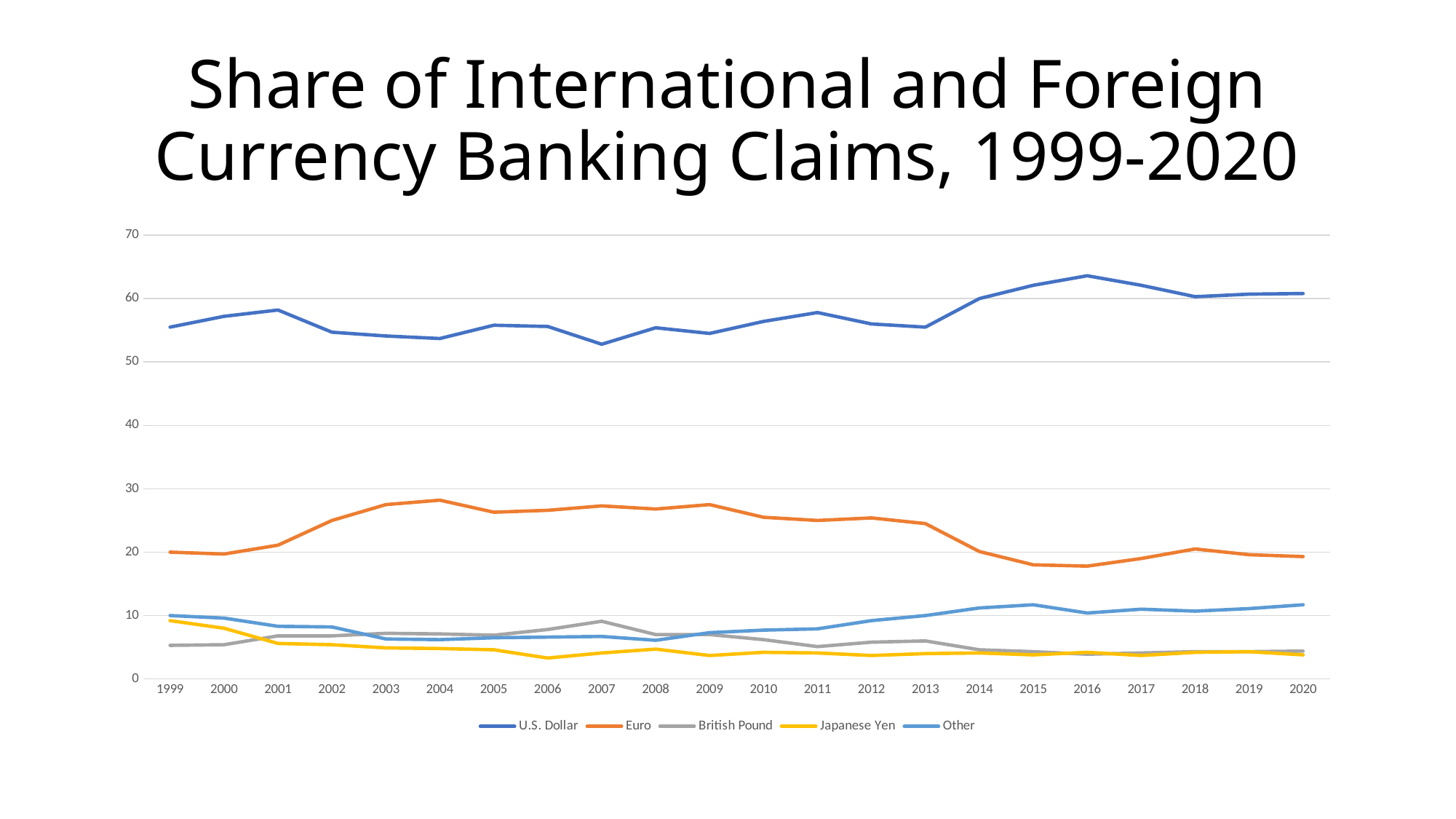
In 2020, which is larger: the Euro share or the Other share? Euro Which series has the highest share in every year shown? U.S. Dollar What kind of chart is shown on the slide? line chart Is the value for Euro in 2016 greater or less than 20? less What is the title of the chart? Share of International and Foreign Currency Banking Claims, 1999-2020 Is the value for U.S. Dollar in 2016 greater or less than 60? greater Is the value for Euro in 2004 greater or less than 30? less How many series does the legend list? 5 In 1999, which is larger: the Japanese Yen share or the British Pound share? Japanese Yen In which year does the U.S. Dollar line reach its highest point? 2016 How many years are plotted along the x axis? 22 Does the U.S. Dollar line rise or fall between 2013 and 2016? rise